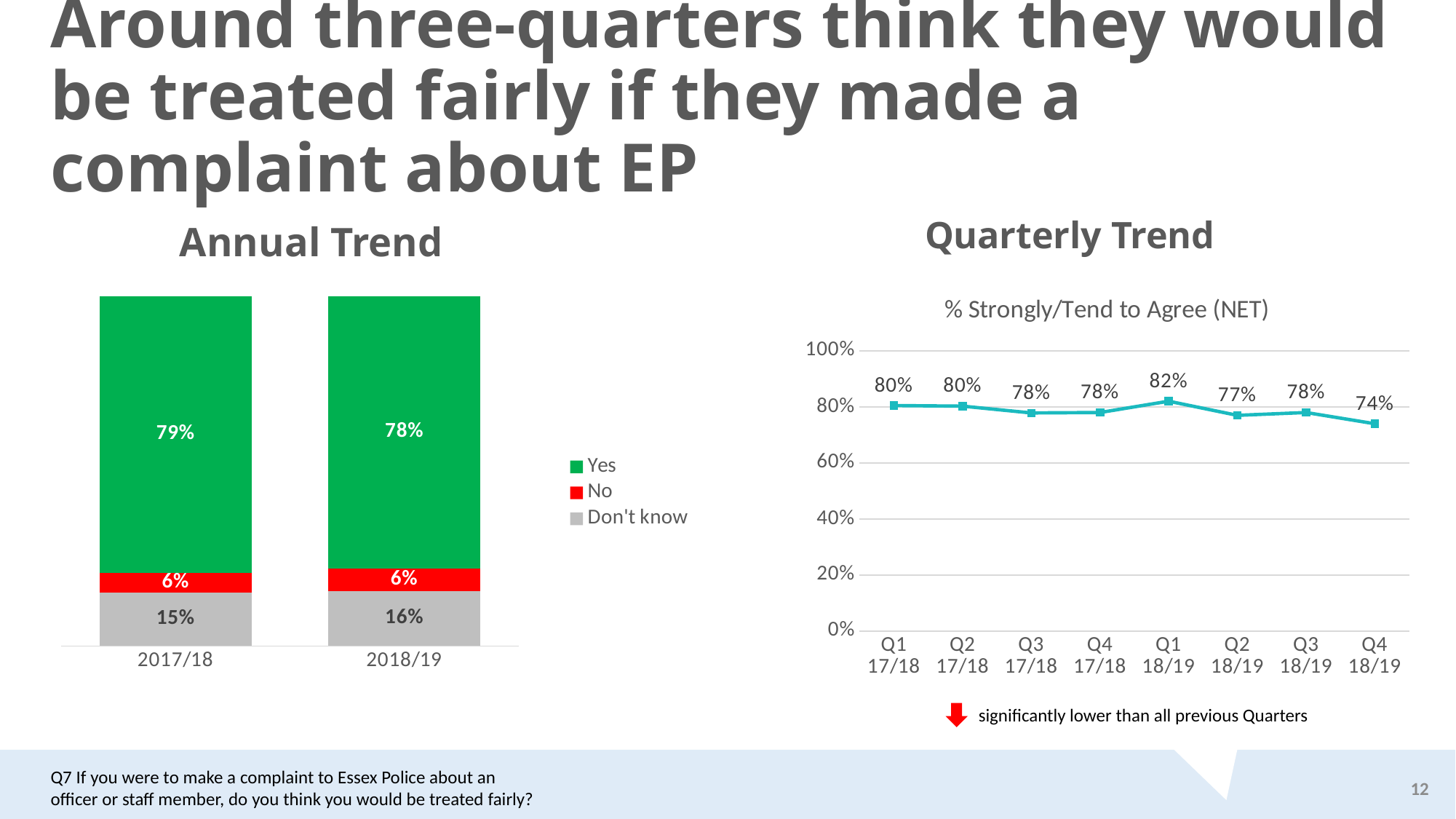
In the Annual Trend chart, what percentage answered Don't know in 2018/19? 16% In the Annual Trend chart, what percentage answered No in 2018/19? 6% In the Quarterly Trend chart, which quarter has the lowest value? Q4 18/19 In the Quarterly Trend chart, how many quarters are plotted? 8 In the Annual Trend chart, what is the total of the 2018/19 bar? 100% In the Quarterly Trend chart, which quarter has the highest value? Q1 18/19 In the Annual Trend chart, how many series does the legend list? 3 In the Annual Trend chart, what percentage answered Yes in 2017/18? 79% In the Quarterly Trend chart, what is the value for Q1 18/19? 82% What kind of chart is the Quarterly Trend chart? Line chart What kind of chart is the Annual Trend chart? Stacked bar chart In the Quarterly Trend chart, what is the difference between Q1 18/19 and Q4 18/19? 8%